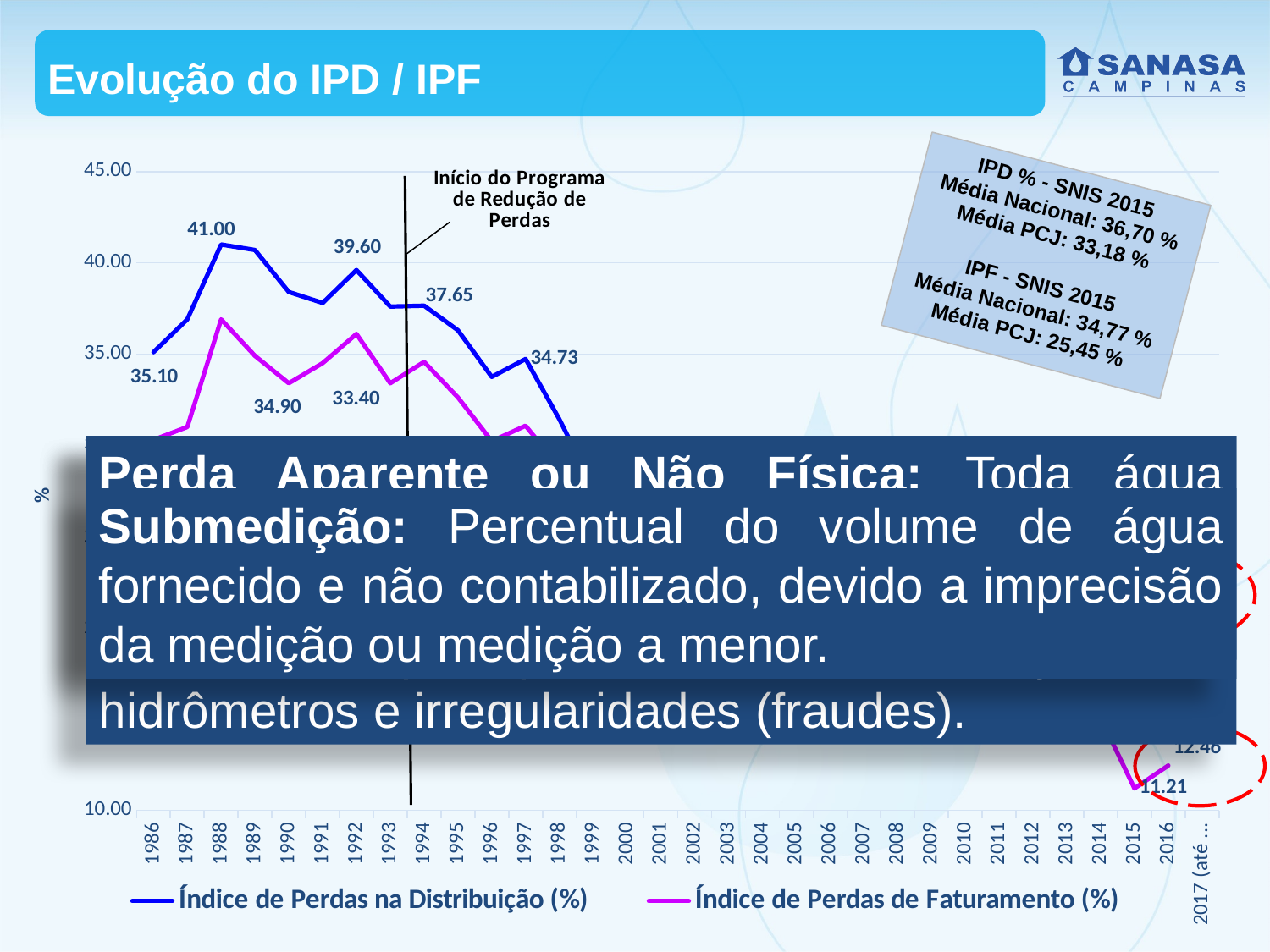
What kind of chart is shown on the slide? line chart Does the Índice de Perdas na Distribuição (%) rise or fall between 1988 and 1997? fall What is the value of the Índice de Perdas na Distribuição (%) in 1988? 41.00 By how much did the Índice de Perdas na Distribuição (%) increase from 1986 to 1988? 5.90 What is the value of the Índice de Perdas na Distribuição (%) in 1994? 37.65 What is the value of the Índice de Perdas na Distribuição (%) in 1997? 34.73 What is the value of the Índice de Perdas na Distribuição (%) in 1986? 35.10 What are the two series named in the chart legend? Índice de Perdas na Distribuição (%) and Índice de Perdas de Faturamento (%) How many series does the chart legend list? 2 In which year does the Índice de Perdas na Distribuição (%) reach its highest value? 1988 What is the value of the Índice de Perdas na Distribuição (%) in 1992? 39.60 Which year has the higher Índice de Perdas na Distribuição (%), 1988 or 1992? 1988